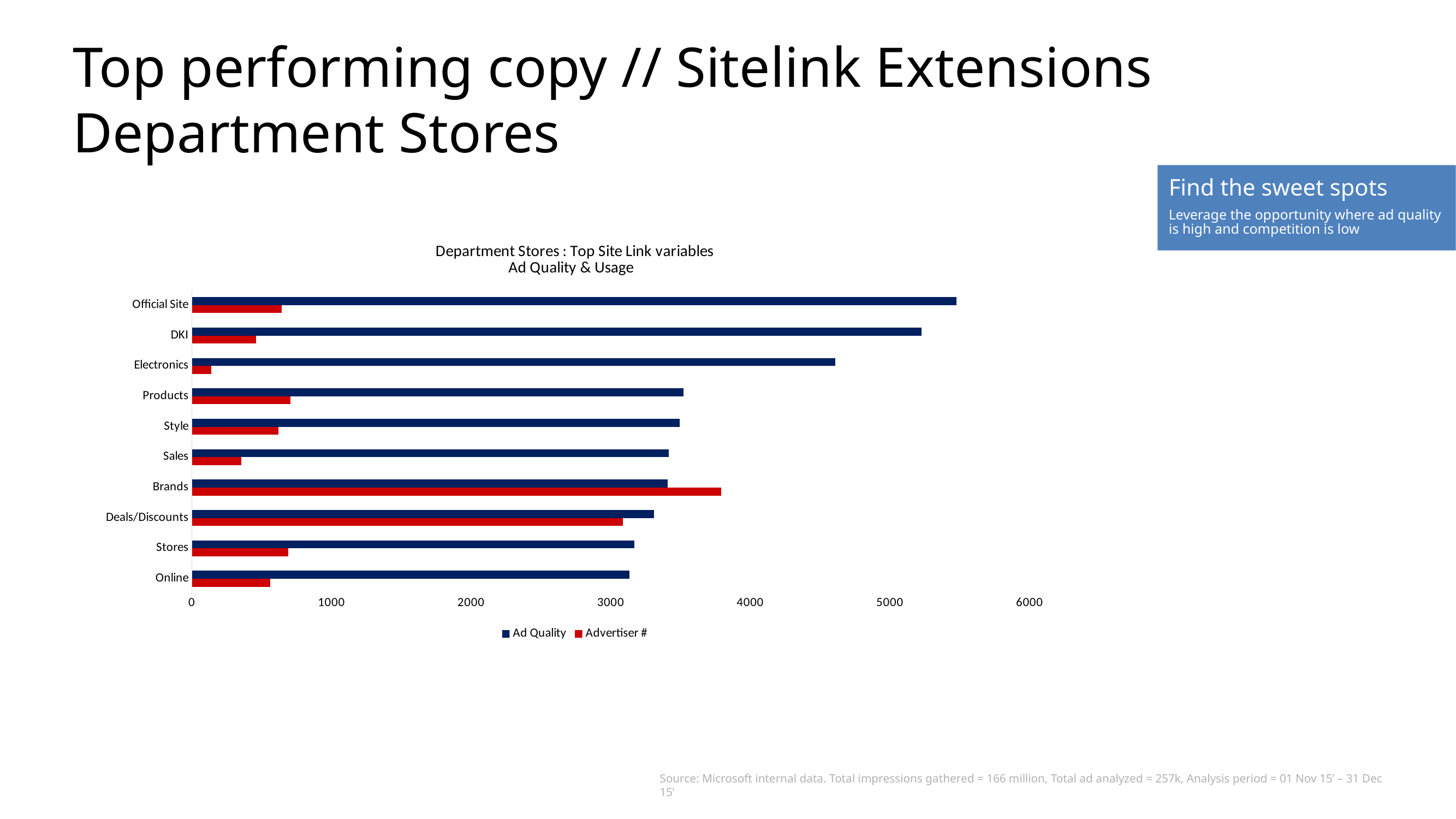
For Brands, which is larger: the Ad Quality value or the Advertiser # value? Advertiser # How many series does the chart legend list? 2 Which has the larger Ad Quality value: Electronics or Products? Electronics Which category has the lowest Advertiser # value? Electronics What kind of chart is shown on the slide? Bar chart Which category has the highest Ad Quality value? Official Site Is the Ad Quality value for Electronics greater or less than 5000? less Which category has the highest Advertiser # value? Brands Is the Advertiser # value for Electronics greater or less than 1000? less Is the Ad Quality value for Official Site greater or less than 5000? greater What colour are the Advertiser # bars in the chart? Red How many categories are plotted on the chart? 10